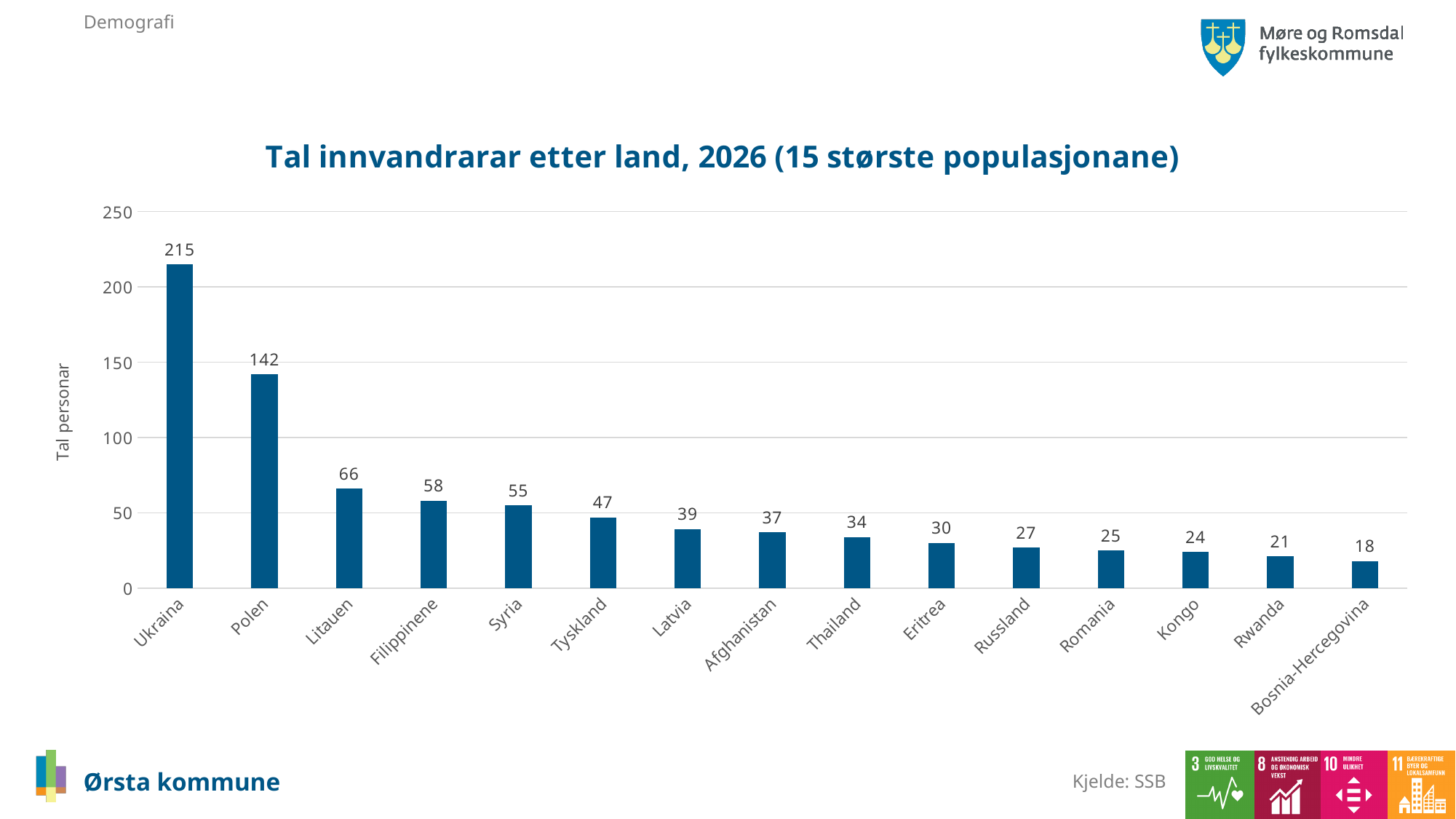
Which country has the highest value? Ukraina What is the value for Polen? 142 How many countries are shown on the chart? 15 Which is larger, the value for Litauen or the value for Syria? Litauen What is the title of the chart? Tal innvandrarar etter land, 2026 (15 største populasjonane) Is the value for Filippinene greater or less than 50? greater What is the value for Eritrea? 30 Which country has the lowest value? Bosnia-Hercegovina Do the values rise or fall from left to right along the x axis? fall What is the value for Tyskland? 47 What kind of chart is this? bar chart What is the difference between the values for Ukraina and Polen? 73